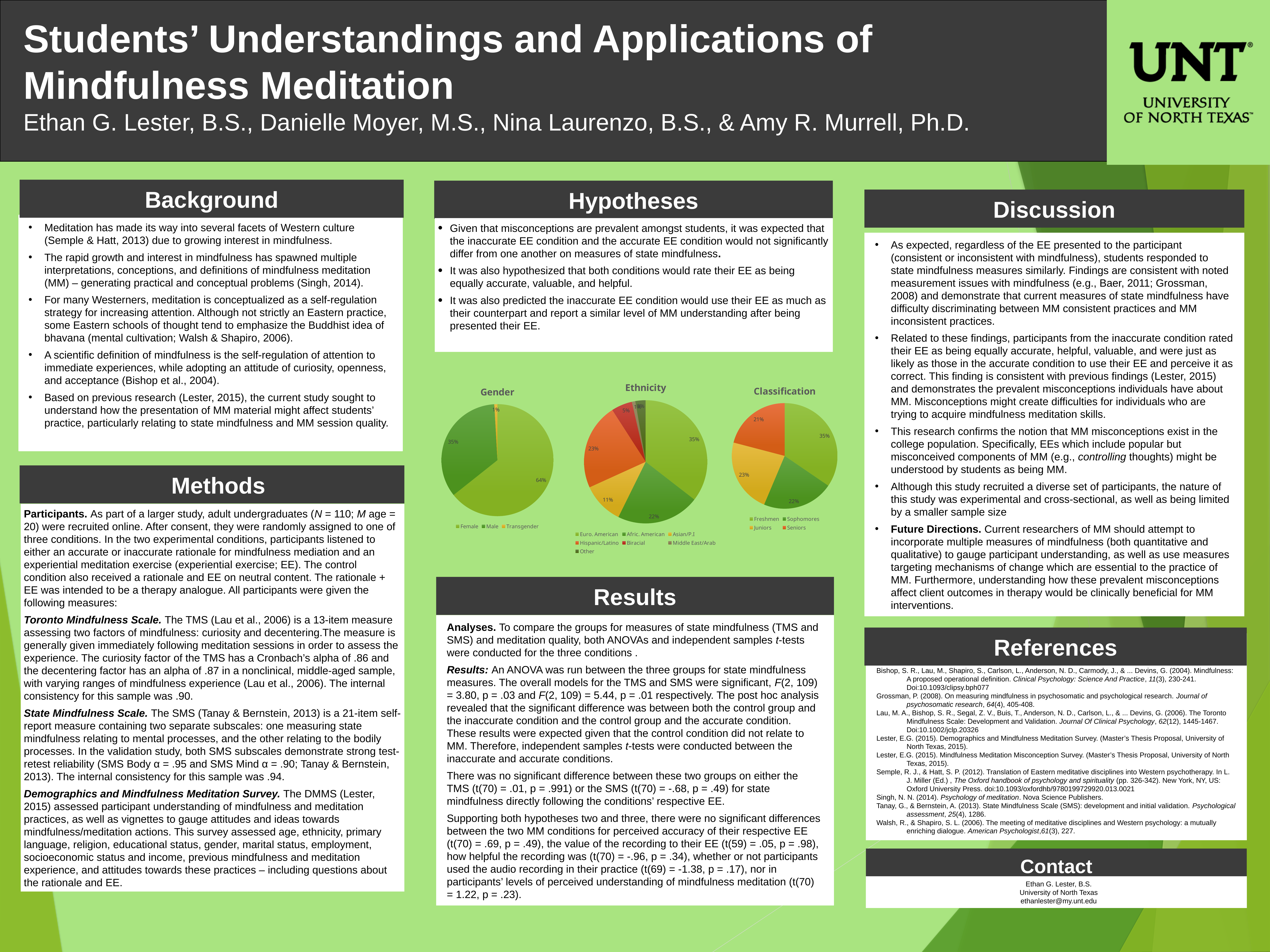
In the Ethnicity chart, how many categories does the legend list? 7 In the Ethnicity chart, what percentage of participants were Hispanic/Latino? 23% In the Gender chart, what percentage of participants were Male? 35% In the Classification chart, what is the difference between the Juniors and Seniors percentages? 2% In the Classification chart, which category has the largest share? Freshmen In the Ethnicity chart, what percentage of participants were Euro. American? 35% In the Ethnicity chart, which is larger, the Afric. American share or the Asian/P.I share? Afric. American In the Classification chart, what percentage of participants were Freshmen? 35% In the Gender chart, which category has the smallest share? Transgender What type of chart is used for the Classification chart? Pie chart In the Gender chart, what is the difference between the Female and Male percentages? 29% In the Gender chart, what percentage of participants were Female? 64%